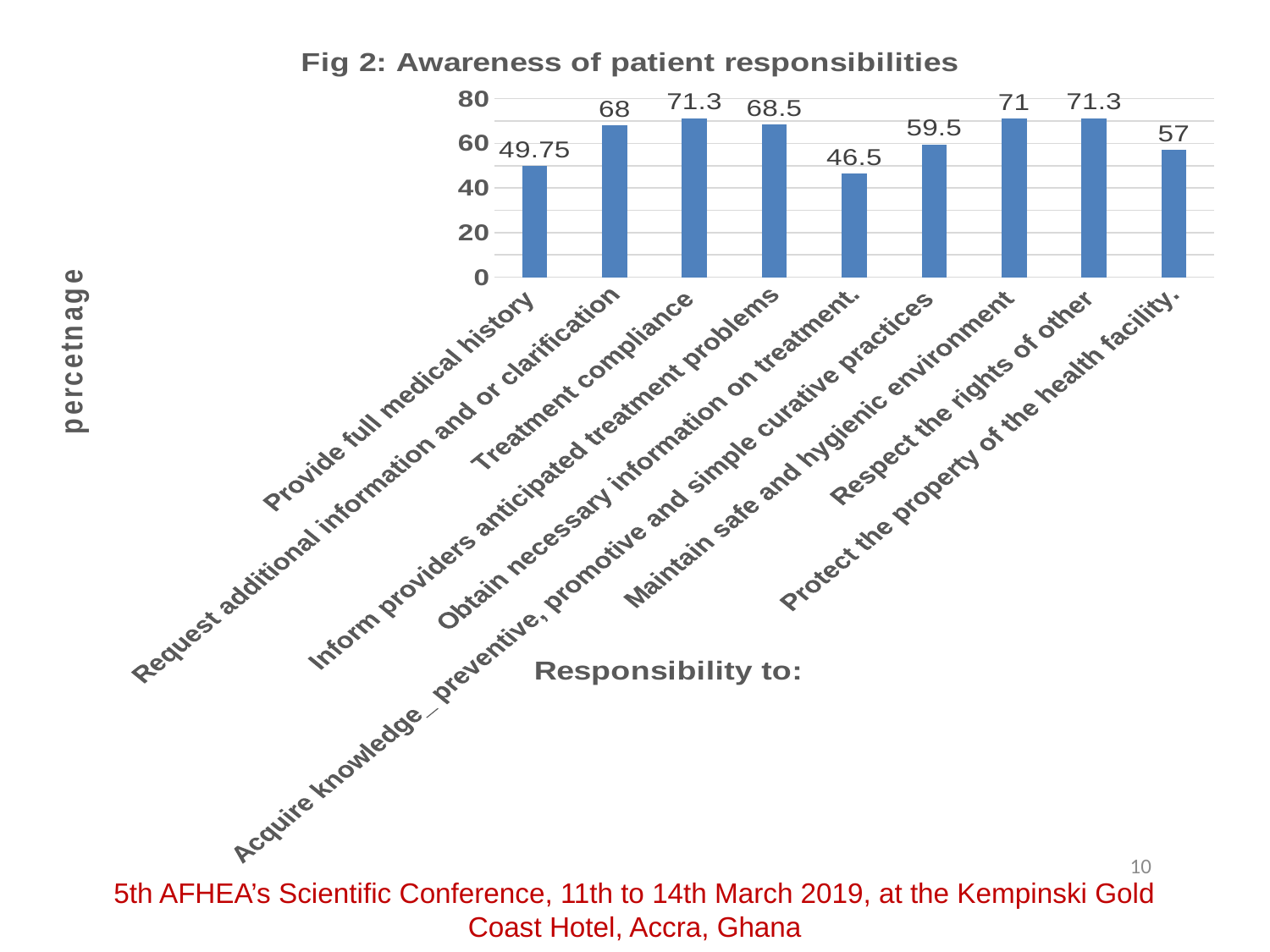
What is the difference between the values for 'Treatment compliance' and 'Provide full medical history'? 21.55 What is the difference between the values for 'Inform providers anticipated treatment problems' and 'Request additional information and or clarification'? 0.5 What kind of chart is shown on the slide? bar chart Which responsibility has the lowest value? Obtain necessary information on treatment. How many responsibility categories are shown in the chart? 9 What is the value for 'Protect the property of the health facility.'? 57 Is the value for 'Respect the rights of other' greater or less than 60? greater What is the value for 'Maintain safe and hygienic environment'? 71 What is the value for 'Obtain necessary information on treatment.'? 46.5 What is the value for 'Provide full medical history'? 49.75 Which is larger: the value for 'Acquire knowledge – preventive, promotive and simple curative practices' or the value for 'Protect the property of the health facility.'? Acquire knowledge – preventive, promotive and simple curative practices What is the title of the chart? Fig 2: Awareness of patient responsibilities